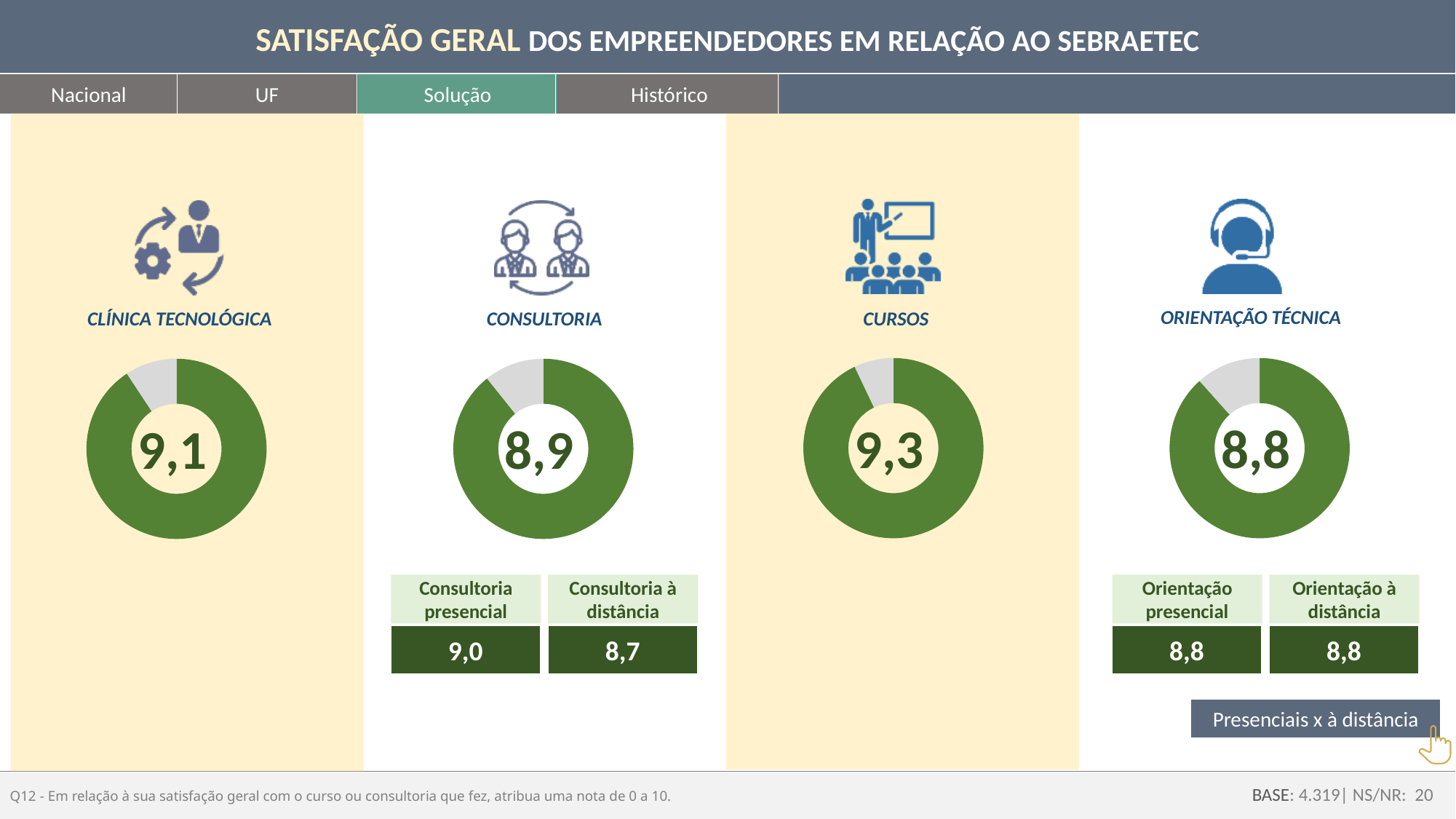
Which of the four solutions (Clínica Tecnológica, Consultoria, Cursos, Orientação Técnica) has the lowest satisfaction score? Orientação Técnica Which has a higher satisfaction score, Clínica Tecnológica or Orientação Técnica? Clínica Tecnológica Under the Consultoria chart, what is the difference between the Consultoria presencial and Consultoria à distância scores? 0,3 How many donut charts are shown on the slide? 4 What kind of chart is used to display each solution's satisfaction score? Donut chart What is the satisfaction score shown in the Consultoria donut chart? 8,9 What is the satisfaction score shown in the Orientação Técnica donut chart? 8,8 Under the Consultoria chart, what is the score for Consultoria à distância? 8,7 What is the satisfaction score shown in the Cursos donut chart? 9,3 What is the satisfaction score shown in the Clínica Tecnológica donut chart? 9,1 What is the difference between the Cursos score and the Consultoria score? 0,4 Which of the four solutions (Clínica Tecnológica, Consultoria, Cursos, Orientação Técnica) has the highest satisfaction score? Cursos